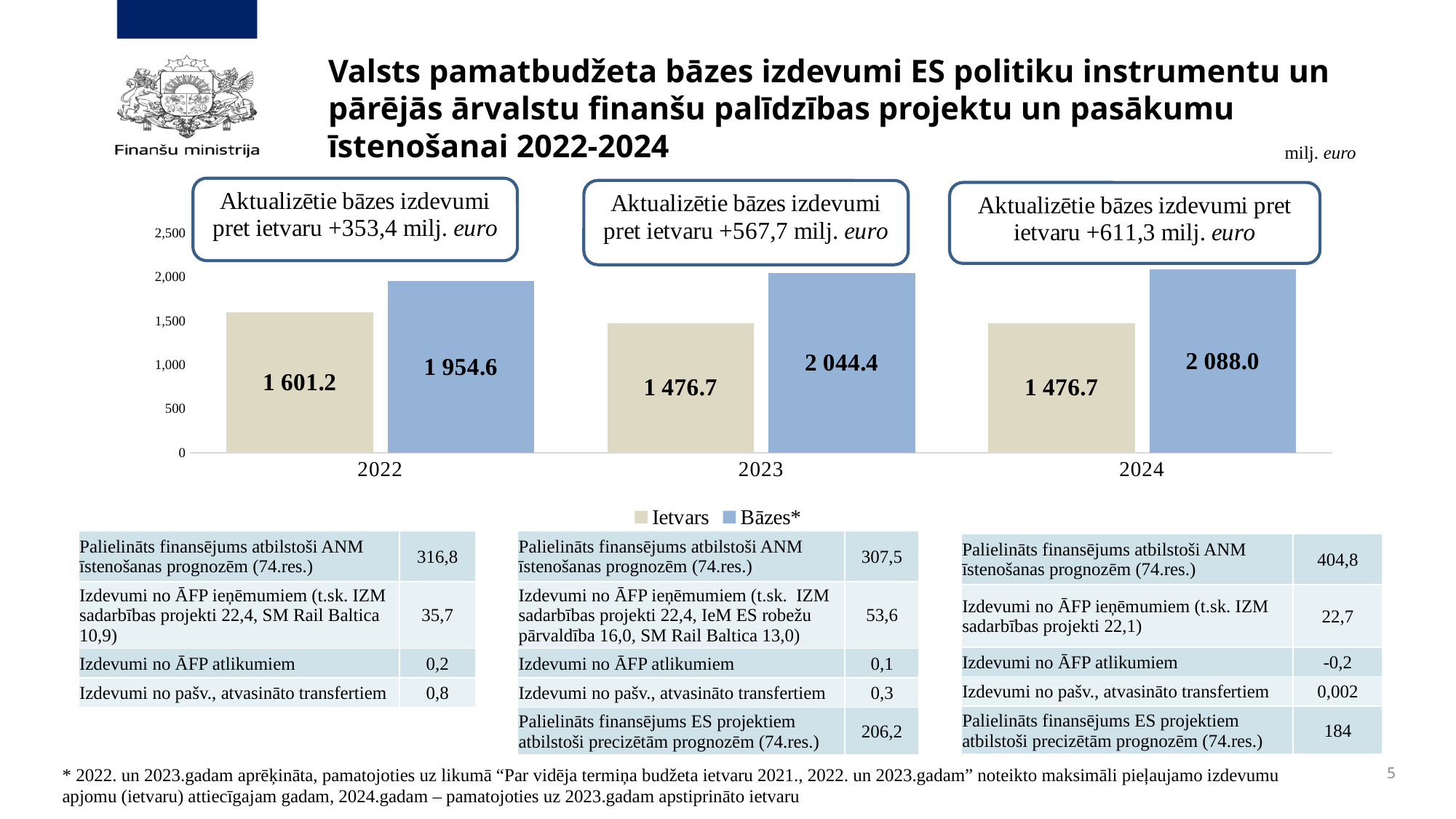
Which year has the highest Ietvars value? 2022 What is the Bāzes* value for 2024? 2 088.0 What is the difference between the Bāzes* and Ietvars values for 2022? 353.4 What kind of chart is shown on the slide? Bar chart How many series does the legend list? 2 What is the Ietvars value for 2022? 1 601.2 Which is larger, the Bāzes* value for 2022 or the Ietvars value for 2022? Bāzes* value for 2022 What is the Ietvars value for 2024? 1 476.7 What is the Bāzes* value for 2023? 2 044.4 What is the difference between the Bāzes* and Ietvars values for 2024? 611.3 How many years are shown on the x axis of the chart? 3 Which year has the highest Bāzes* value? 2024